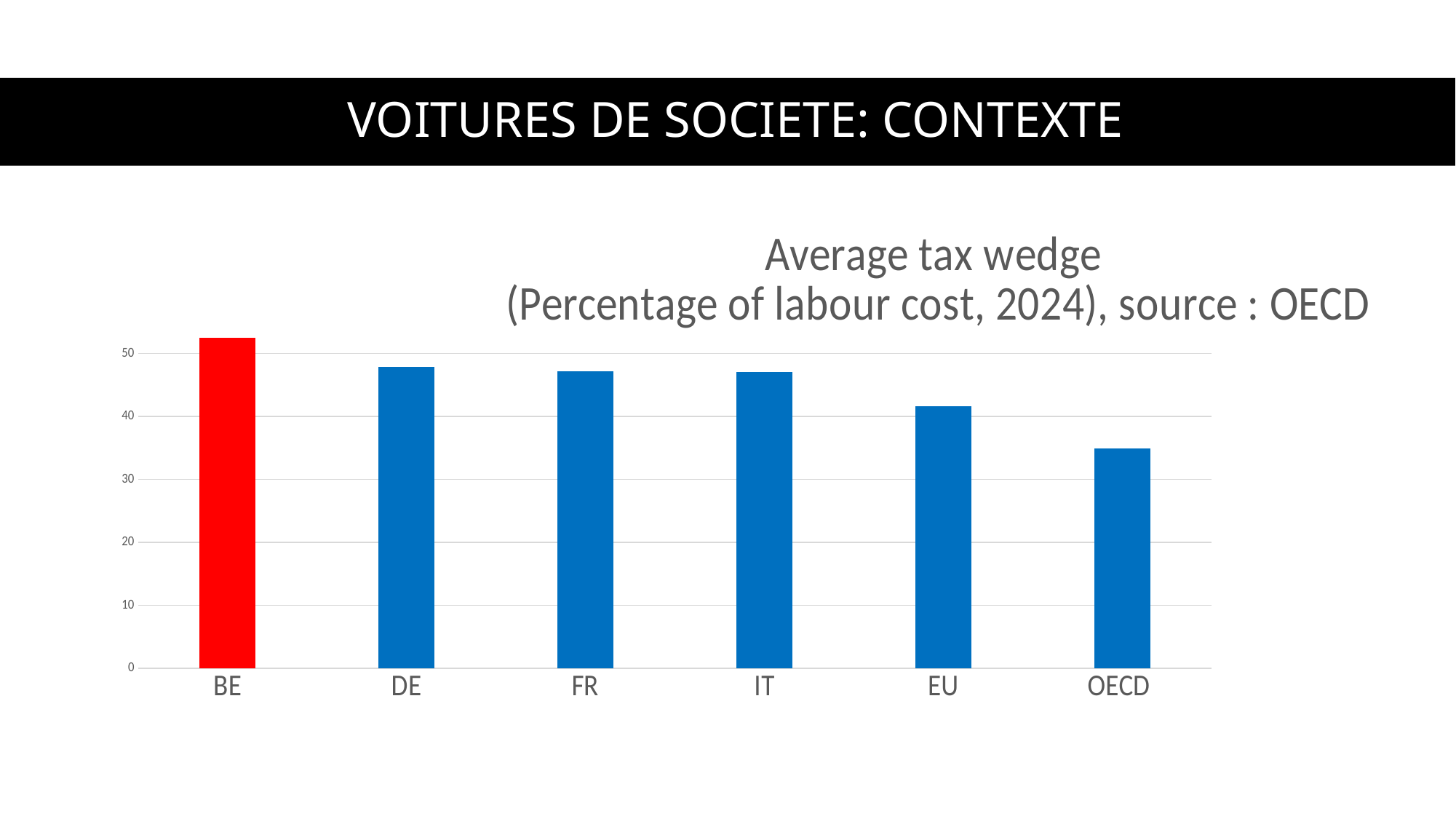
Is the value for BE greater or less than 50? greater Is the value for EU greater or less than 40? greater Which is larger, the value for EU or the value for OECD? EU Which is larger, the value for BE or the value for DE? BE Which category has the highest average tax wedge? BE Is the value for DE greater or less than 50? less Which category has the lowest average tax wedge? OECD Do the values rise or fall from left to right along the x axis? fall Which bar is coloured red in the chart? BE How many categories are shown on the x axis of the chart? 6 What kind of chart is shown on the slide? bar chart